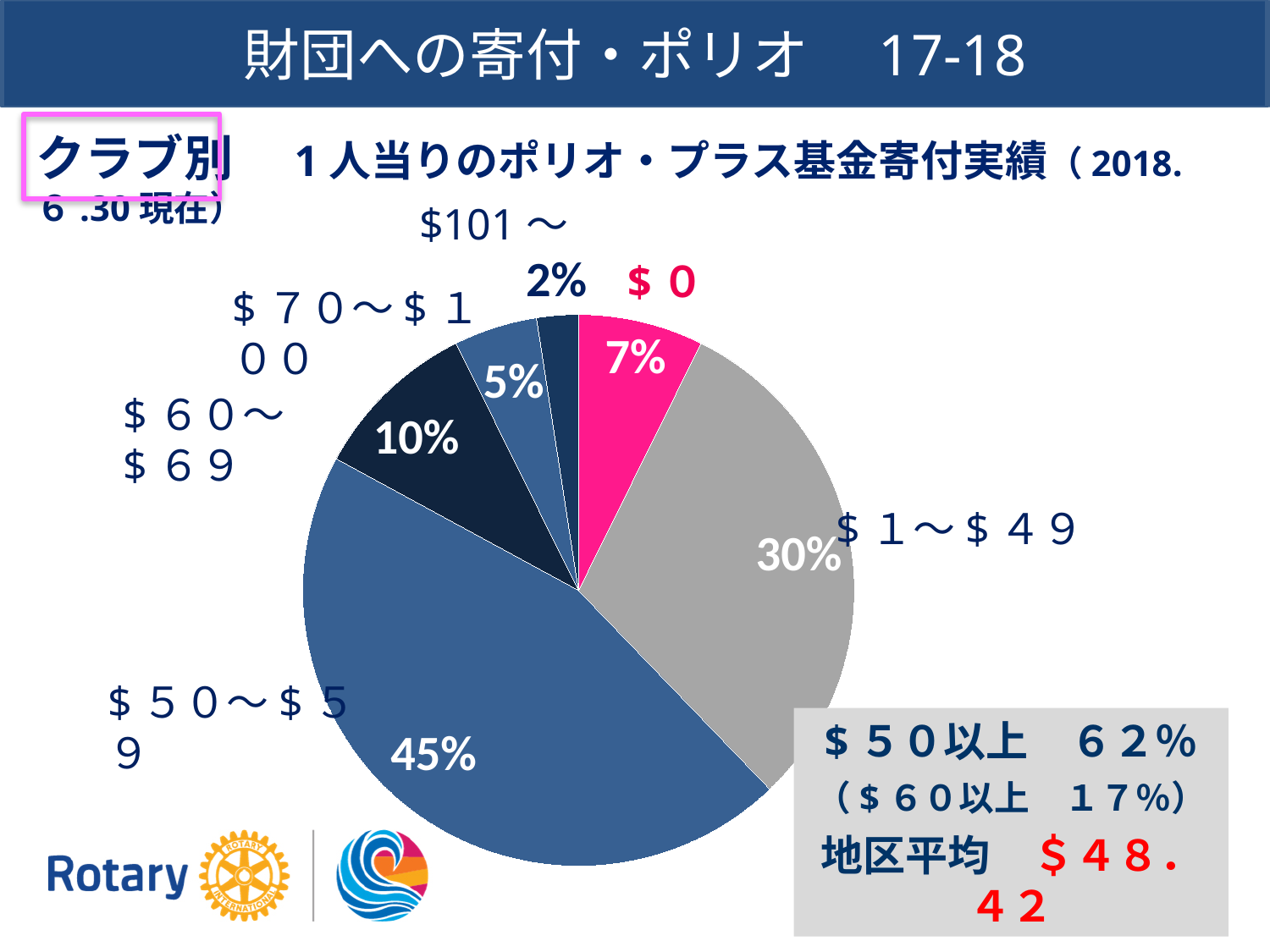
How many slices does the pie chart have? 6 Which slice is larger, $70〜$100 or $60〜$69? $60〜$69 What percentage is shown for the $60〜$69 slice? 10% What percentage is shown for the $101〜 slice? 2% Which category has the smallest share of the pie? $101〜 What percentage is shown for the $0 slice? 7% What kind of chart is shown on the slide? pie chart What colour is the $0 slice of the pie? pink Which category has the largest share of the pie? $50〜$59 What percentage of clubs fall in the $50〜$59 category? 45% What is the difference in percentage points between the $50〜$59 slice and the $1〜$49 slice? 15 What percentage is shown for the $1〜$49 slice? 30%